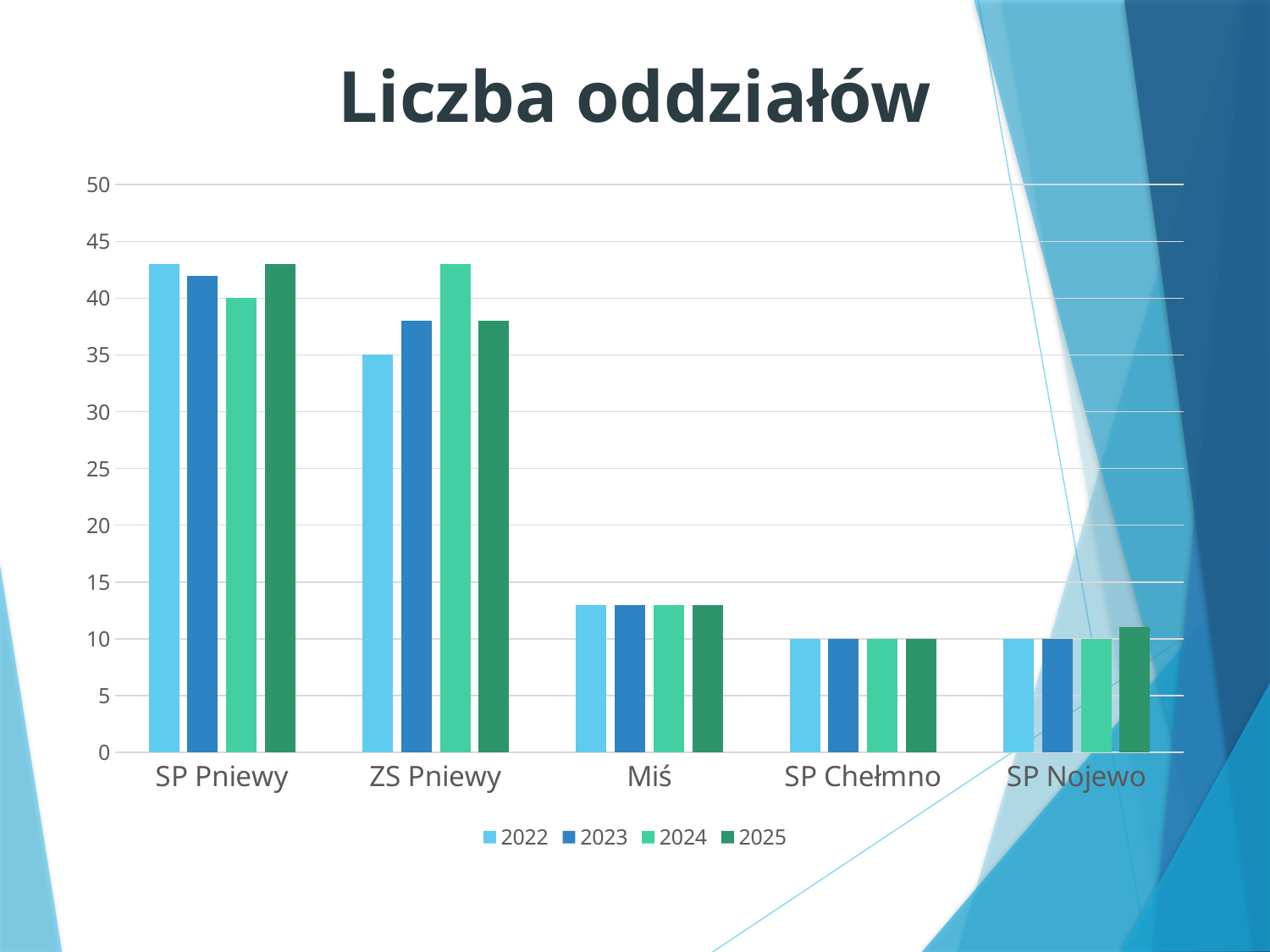
What kind of chart is shown on the slide? bar chart Is the value for Miś in 2023 greater or less than 15? less What is the value for SP Pniewy in 2024? 40 How many series does the legend list? 4 How many categories are shown on the x axis? 5 What is the title of the chart? Liczba oddziałów Which category has the lowest value in 2025? SP Chełmno Which category has the highest value in 2023? SP Pniewy What is the value for ZS Pniewy in 2022? 35 Is the value for SP Pniewy in 2022 greater or less than 40? greater Which is larger for ZS Pniewy: the 2022 value or the 2024 value? 2024 What is the value for SP Chełmno in 2022? 10